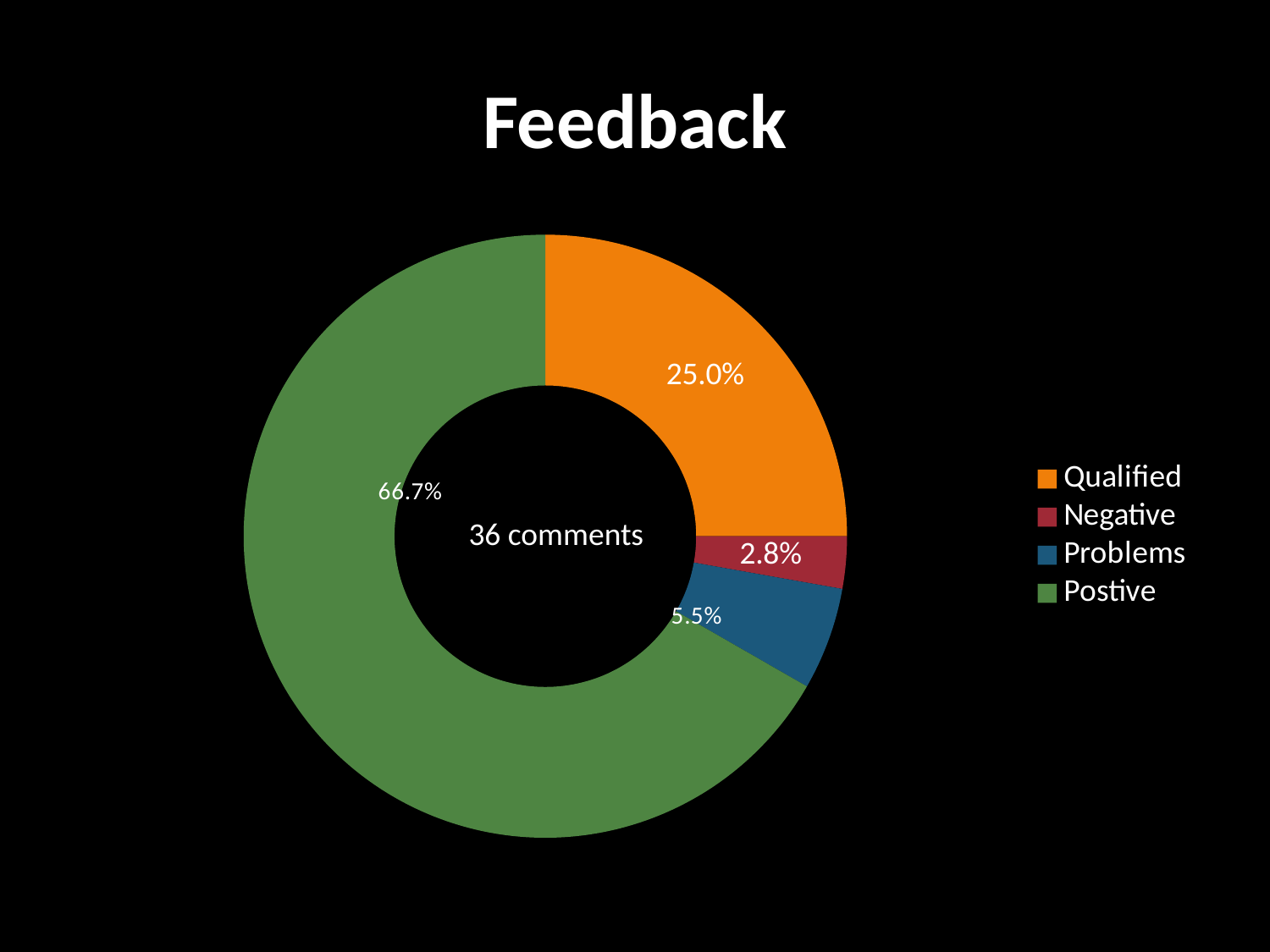
What colour represents Qualified in the Feedback chart? Orange What share of the Feedback chart is labelled Problems? 5.5% What share of the Feedback chart is labelled Postive? 66.7% What share of the Feedback chart is labelled Negative? 2.8% Which category has the smallest share in the Feedback chart? Negative What share of the Feedback chart is labelled Qualified? 25.0% Which category has the largest share in the Feedback chart? Postive How many categories does the Feedback chart show? 4 What is the difference in percentage points between the Postive and Qualified shares? 41.7 What text appears in the centre of the Feedback chart? 36 comments What kind of chart is shown on the slide? Doughnut (pie) chart Which is larger in the Feedback chart, the Problems share or the Negative share? Problems